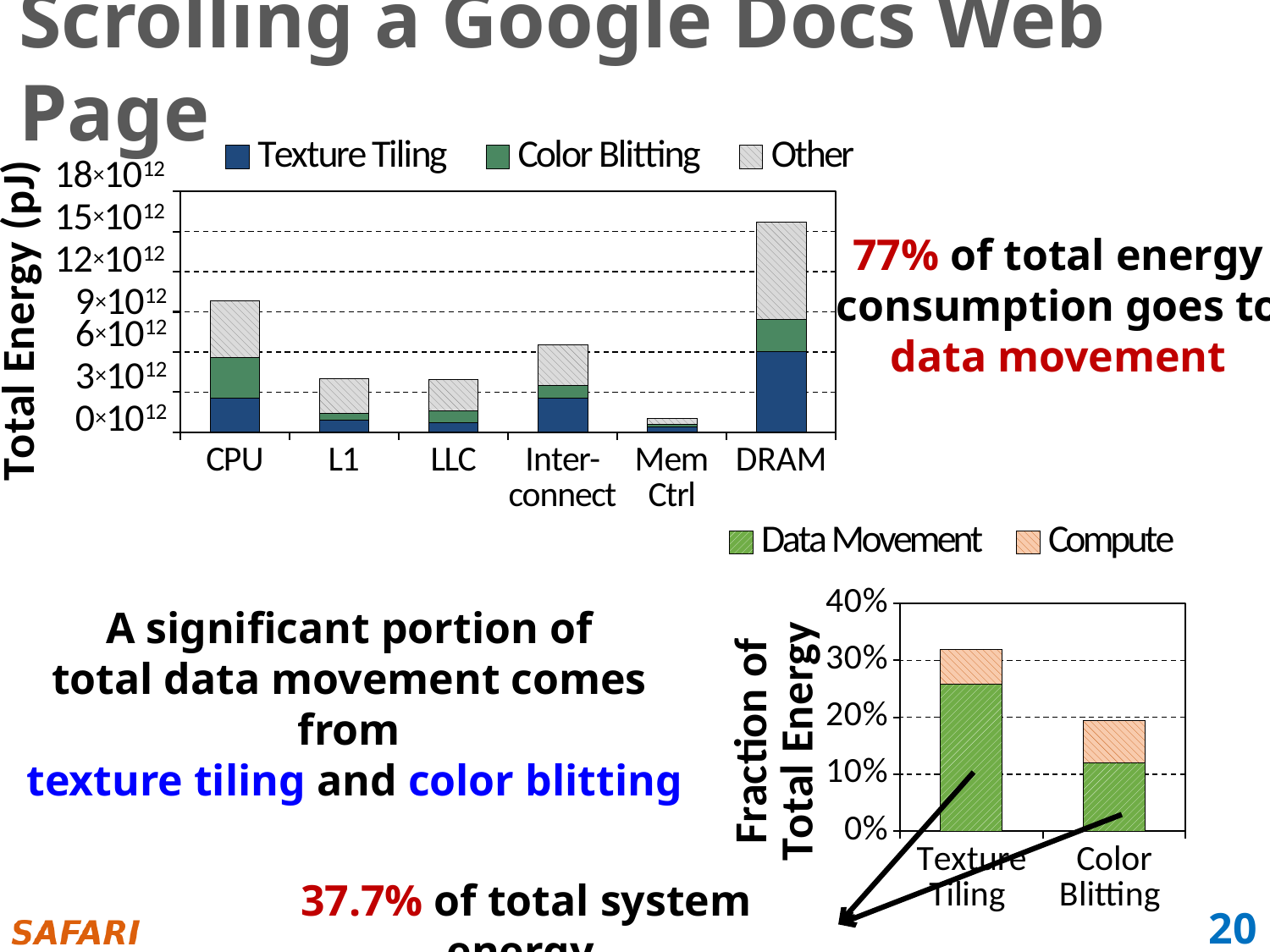
In the top chart (Total Energy), which category has the lowest total energy? Mem Ctrl In the bottom chart (Fraction of Total Energy), how many series does the legend list? 2 In the top chart (Total Energy), how many categories are shown on the x axis? 6 In the top chart (Total Energy), is the total value for CPU greater or less than 6×10^12? greater In the top chart (Total Energy), is the total value for L1 greater or less than 6×10^12? less What kind of chart is the top chart on the slide (Total Energy)? stacked bar chart In the top chart (Total Energy), is the total value for DRAM greater or less than 12×10^12? greater In the top chart (Total Energy), which category has the highest total energy? DRAM In the top chart (Total Energy), how many series does the legend list? 3 In the top chart (Total Energy), which has a larger total energy, CPU or LLC? CPU In the bottom chart (Fraction of Total Energy), which category has the higher total fraction, Texture Tiling or Color Blitting? Texture Tiling